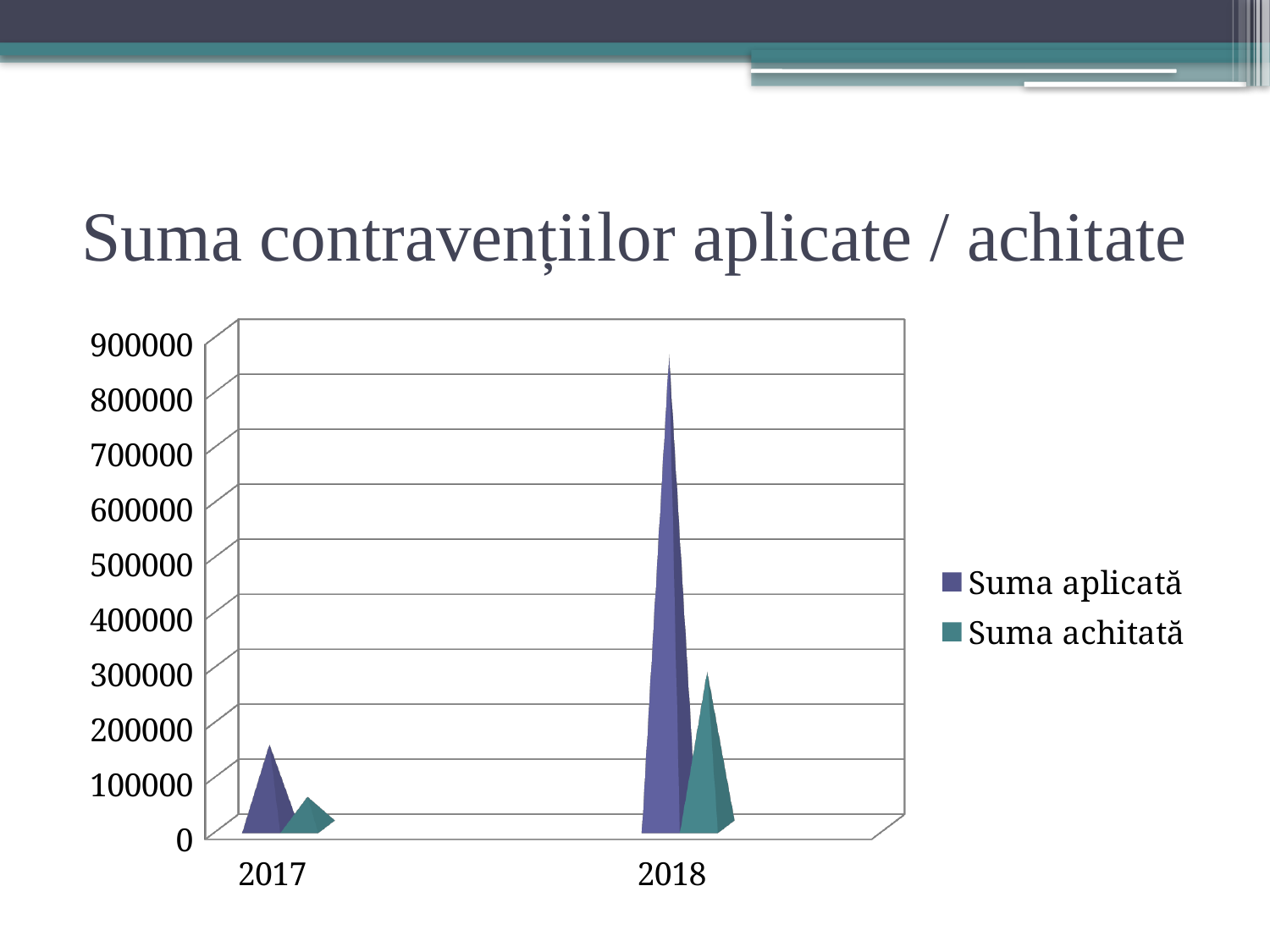
What is the title of the slide containing the chart? Suma contravențiilor aplicate / achitate Is the value for Suma achitată in 2018 greater or less than 200000? greater Is the value for Suma achitată in 2017 greater or less than 100000? less Do the values for Suma aplicată rise or fall from 2017 to 2018? rise Is the value for Suma aplicată in 2017 greater or less than 200000? less In 2018, which is larger: Suma aplicată or Suma achitată? Suma aplicată How many categories are shown on the x axis? 2 What kind of chart is shown on the slide? bar chart Which year has the highest value for Suma aplicată? 2018 How many series does the legend list? 2 Which year has the lowest value for Suma achitată? 2017